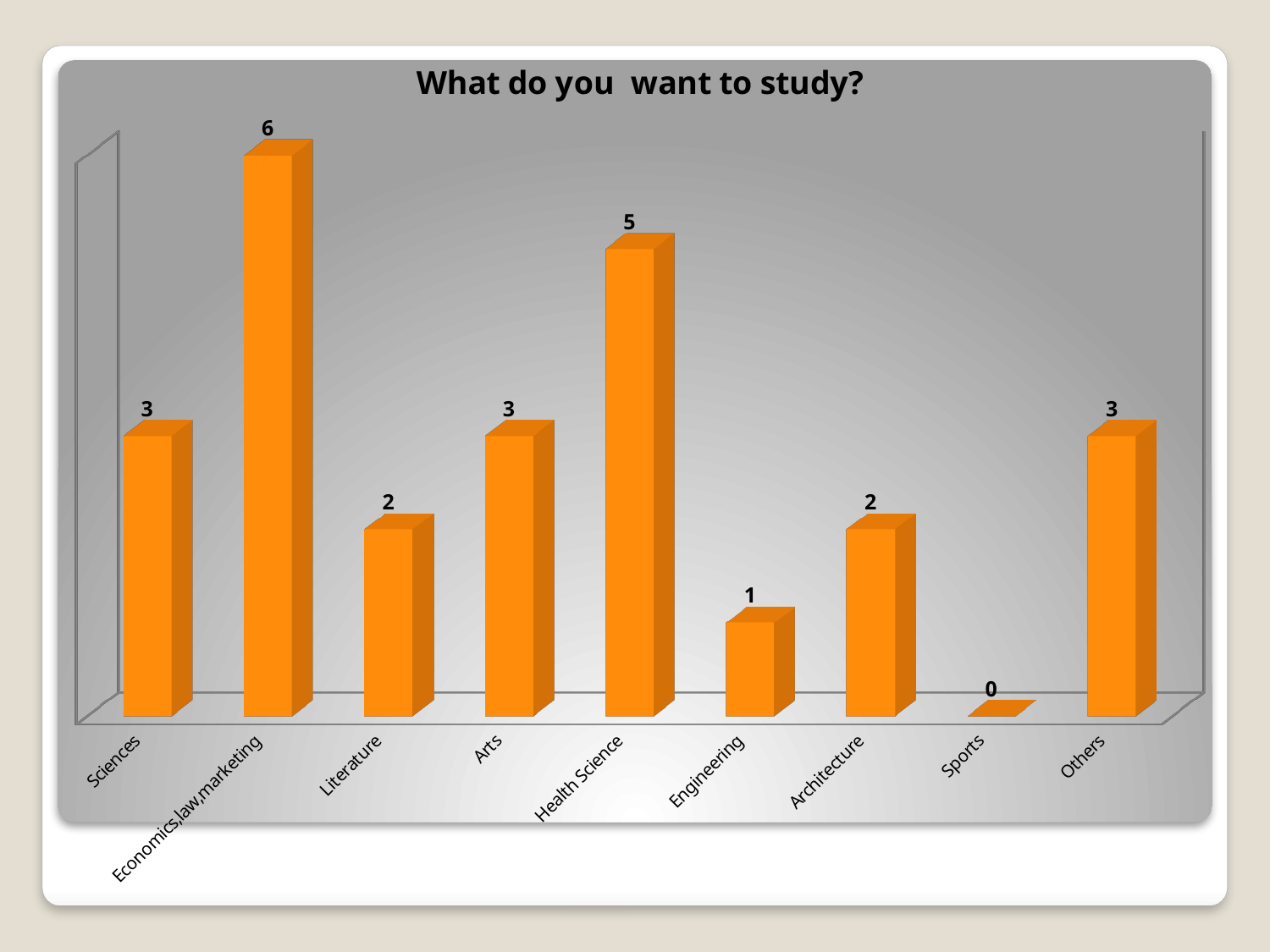
What is the difference between the values for Economics,law,marketing and Health Science? 1 Which category has the lowest value? Sports What is the value for Engineering? 1 What is the value for Sports? 0 How many categories are shown on the x axis? 9 Which is larger, the value for Architecture or the value for Others? Others What is the title of the chart? What do you want to study? What is the value for Health Science? 5 What kind of chart is shown on the slide? bar chart Which category has the highest value? Economics,law,marketing What is the difference between the values for Arts and Literature? 1 What is the value for Economics,law,marketing? 6